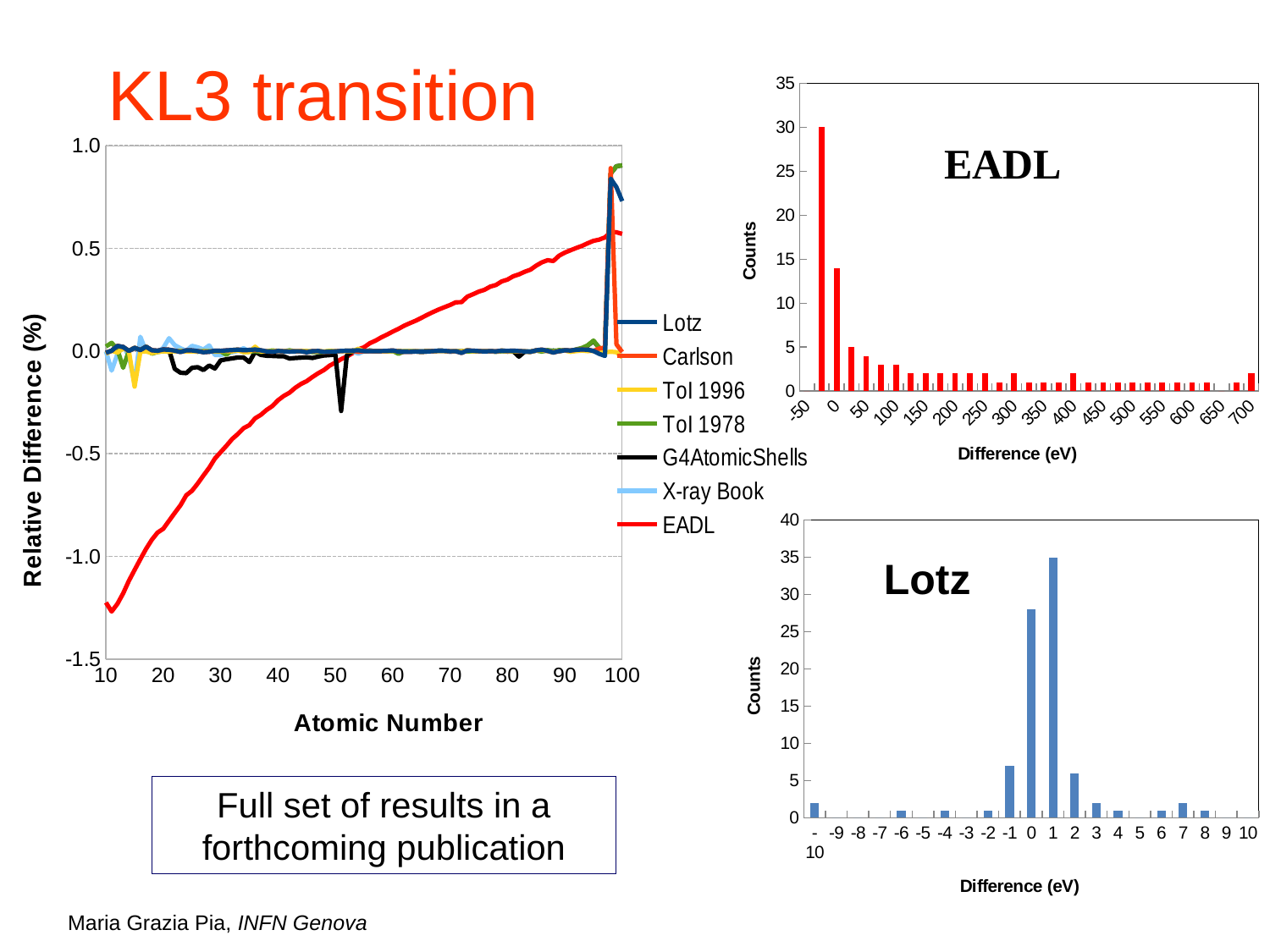
What kind of chart is the large chart on the left with Atomic Number on the x axis? line chart In the left chart, which series is drawn in red? EADL In the Lotz chart, which has the larger count: difference 0 or difference 1? 1 In the left chart, does the EADL series rise or fall as atomic number increases? rises What kind of chart is the EADL chart on the right? bar chart How many series does the legend of the left chart list? 7 In the Lotz chart, which difference value has the highest count? 1 What is the x-axis title of the left chart? Atomic Number In the Lotz chart, is the count for a difference of -1 greater or less than 10? less In the EADL chart, is the tallest bar greater or less than 25 counts? greater In the Lotz chart, what is the count for a difference of 1 eV? 35 In the Lotz chart, is the count for a difference of 0 greater or less than 25? greater